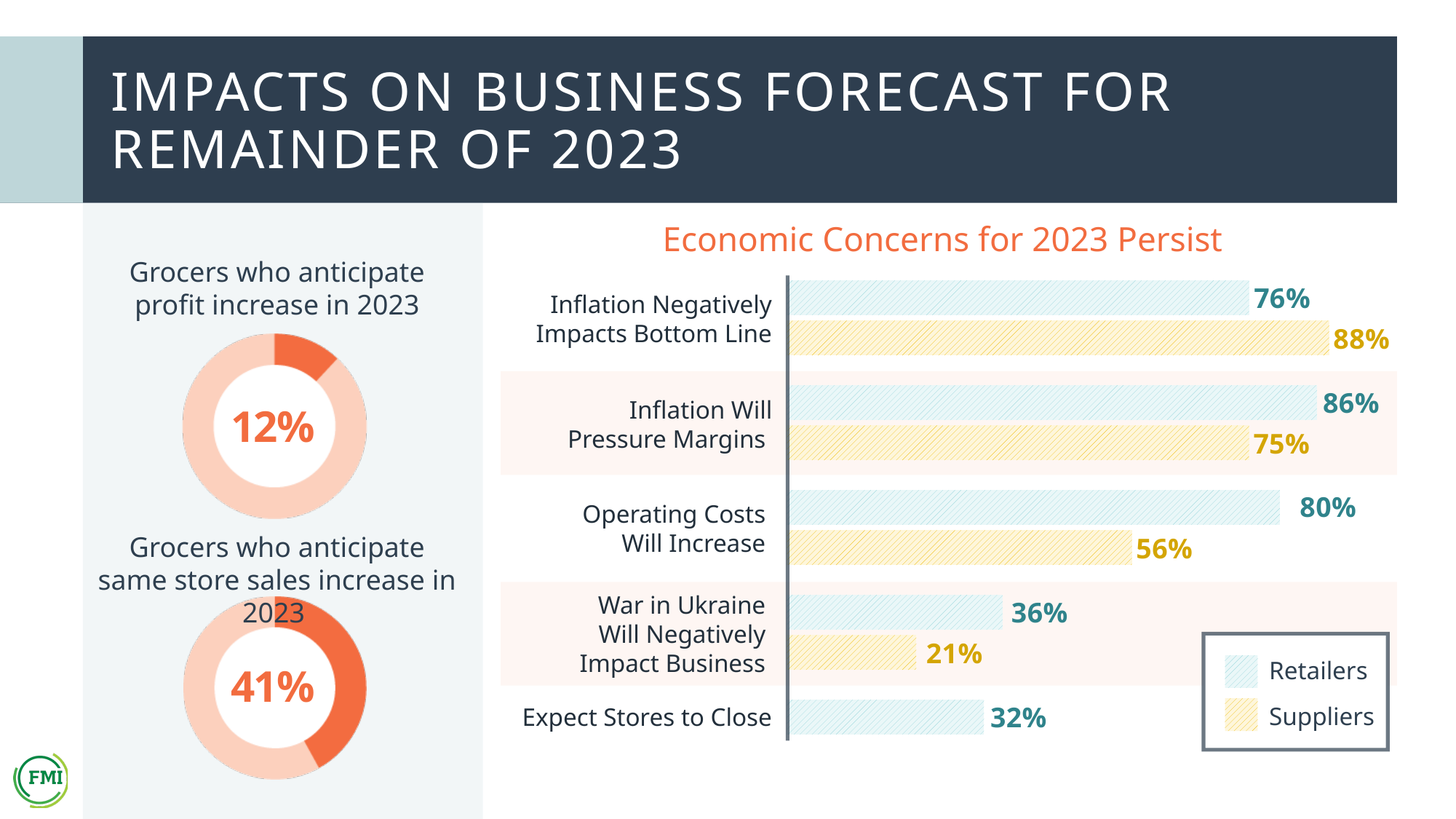
In the 'Economic Concerns for 2023 Persist' chart, which category has the lowest Suppliers value? War in Ukraine Will Negatively Impact Business In the bottom donut chart on the left, what percentage of grocers anticipate a same store sales increase in 2023? 41% In the 'Economic Concerns for 2023 Persist' chart, what is the Suppliers value for 'Operating Costs Will Increase'? 56% In the 'Economic Concerns for 2023 Persist' chart, which category has the highest Retailers value? Inflation Will Pressure Margins In the top donut chart on the left, what percentage of grocers anticipate a profit increase in 2023? 12% How many series does the legend of the 'Economic Concerns for 2023 Persist' chart list? 2 How many categories are shown in the 'Economic Concerns for 2023 Persist' chart? 5 In the 'Economic Concerns for 2023 Persist' chart, what is the difference between the Retailers and Suppliers values for 'Operating Costs Will Increase'? 24 percentage points In the 'Economic Concerns for 2023 Persist' chart, for 'Inflation Negatively Impacts Bottom Line', which series has the larger value, Retailers or Suppliers? Suppliers What kind of chart is 'Economic Concerns for 2023 Persist'? Bar chart In the 'Economic Concerns for 2023 Persist' chart, what is the Retailers value for 'Inflation Negatively Impacts Bottom Line'? 76% In the 'Economic Concerns for 2023 Persist' chart, what is the Retailers value for 'Expect Stores to Close'? 32%